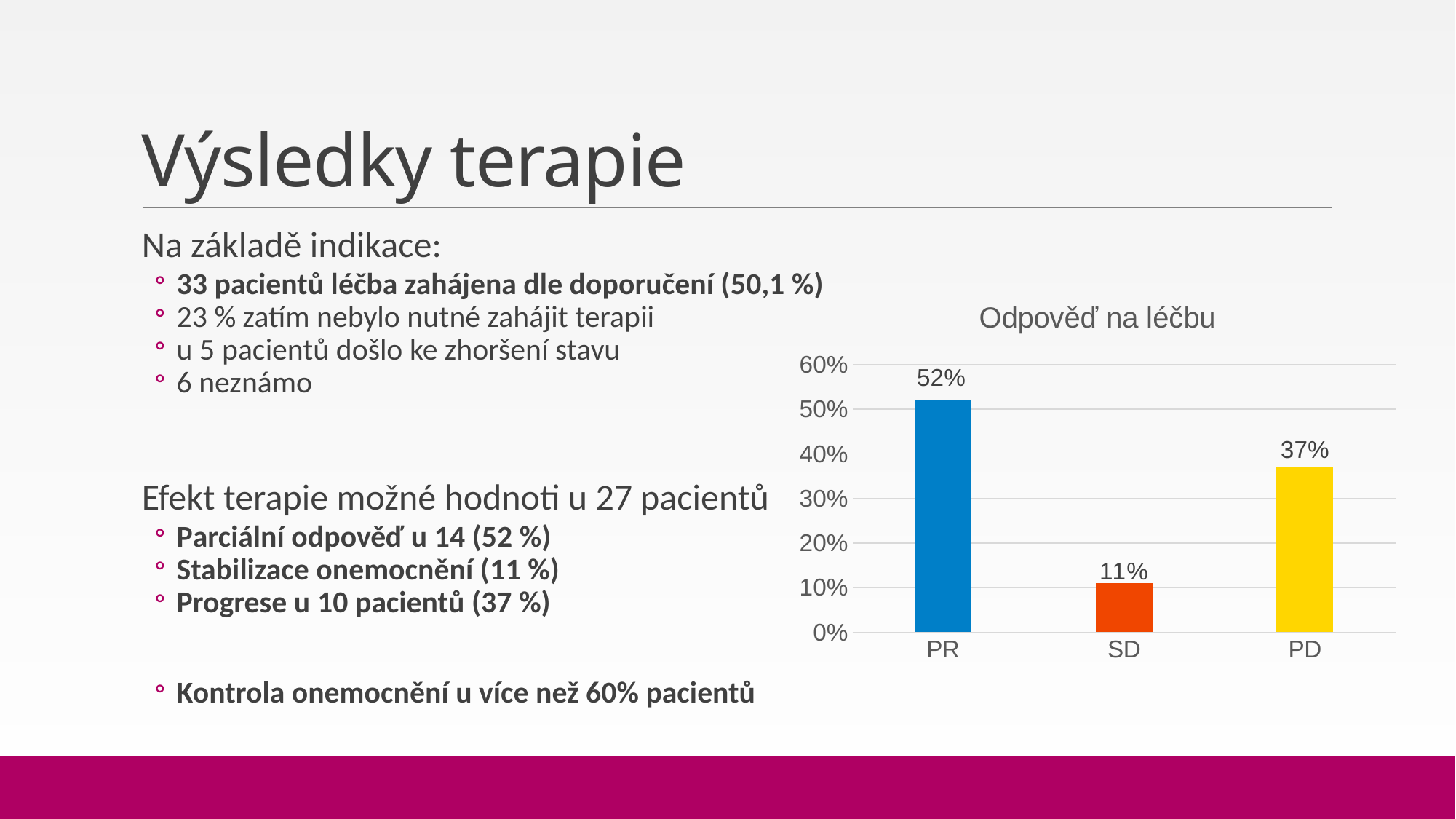
Which category has the highest value in the chart? PR What is the title of the chart? Odpověď na léčbu Which category has the lowest value in the chart? SD Is the value for PR greater or less than 50%? greater What kind of chart is shown on the slide? bar chart What is the difference between the values for PR and PD? 15% What is the value for PD in the chart? 37% How many categories are shown on the x axis of the chart? 3 Which is larger, the value for SD or the value for PD? PD What is the value for PR in the chart? 52% What is the difference between the values for PD and SD? 26% What is the value for SD in the chart? 11%